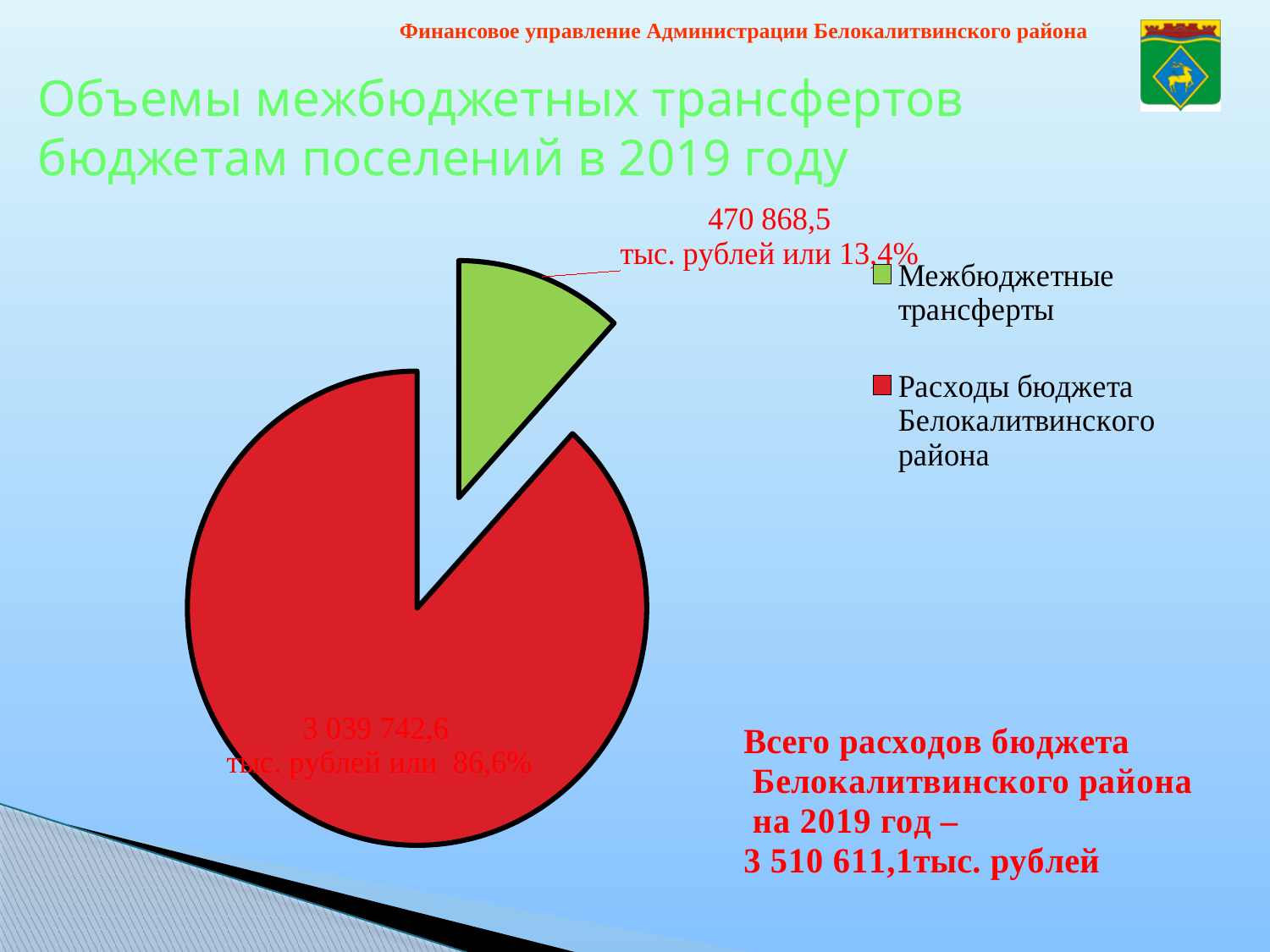
How many slices does the pie chart have? 2 Which slice of the pie chart is the largest? Расходы бюджета Белокалитвинского района What value is labelled on the slice for Межбюджетные трансферты? 470 868,5 тыс. рублей Which slice of the pie chart is the smallest? Межбюджетные трансферты What share of the pie does the Расходы бюджета Белокалитвинского района slice represent? 86,6% What share of the pie does the Межбюджетные трансферты slice represent? 13,4% What colour is the slice for Межбюджетные трансферты? green What is the total of the two slices in the pie chart, as stated on the slide? 3 510 611,1 тыс. рублей How many entries does the legend of the pie chart list? 2 What value is labelled on the slice for Расходы бюджета Белокалитвинского района? 3 039 742,6 тыс. рублей What kind of chart is shown on the slide? pie chart Which is larger: Межбюджетные трансферты or Расходы бюджета Белокалитвинского района? Расходы бюджета Белокалитвинского района